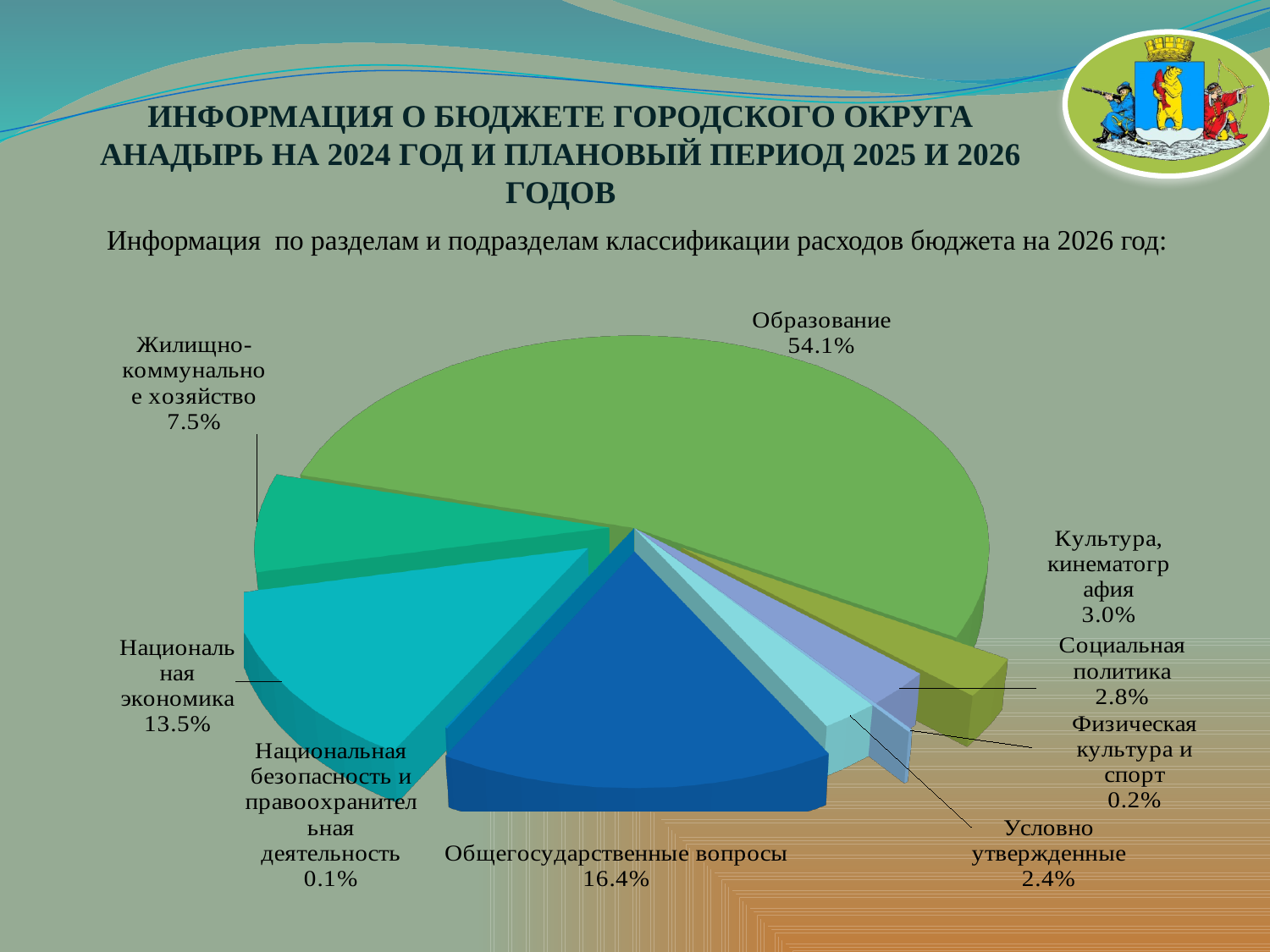
What is the difference between the shares of Общегосударственные вопросы and Национальная экономика? 2.9% Which is larger: the share for Культура, кинематография or the share for Социальная политика? Культура, кинематография What is the value shown for Общегосударственные вопросы? 16.4% Which year's budget expenditures does the pie chart describe? 2026 How many sections are shown in the pie chart? 9 What type of chart is shown on the slide? Pie chart What share is shown for Условно утвержденные? 2.4% What share of the 2026 budget expenditures goes to Образование? 54.1% What percentage is shown for Национальная экономика? 13.5% Which section has the smallest share of the pie? Национальная безопасность и правоохранительная деятельность Which section has the largest share of the pie? Образование What is the value for Жилищно-коммунальное хозяйство? 7.5%